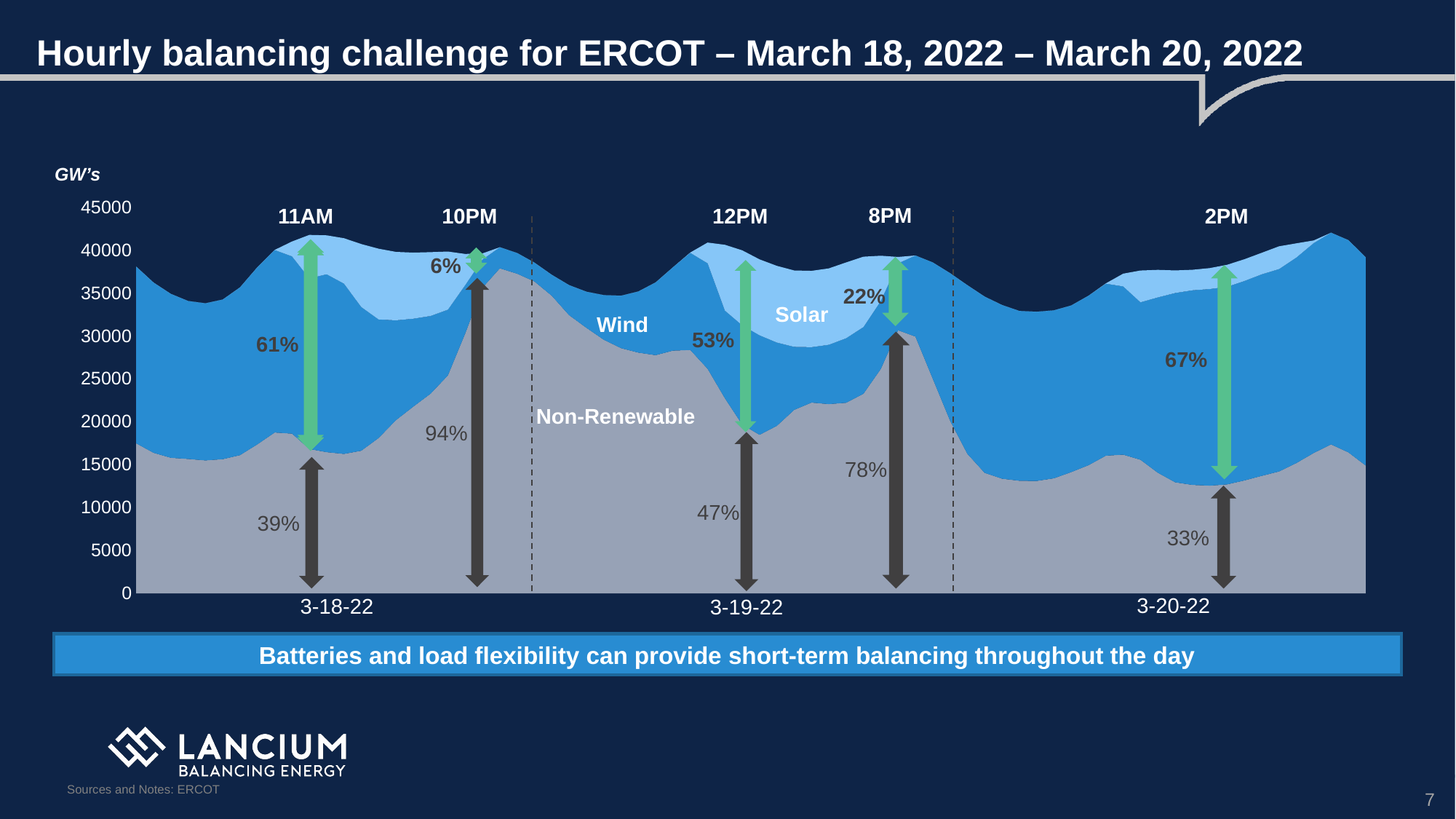
What renewable share (green arrow) is labelled at 2PM on 3-20-22? 67% At which labelled time is the renewable share (green arrow) the lowest? 10PM on 3-18-22 Which is larger: the renewable share labelled at 12PM on 3-19-22 or the renewable share labelled at 8PM on 3-19-22? 12PM on 3-19-22 What is the difference between the renewable share (61%) and the non-renewable share (39%) labelled at 11AM on 3-18-22? 22 percentage points Is the Non-Renewable value at 11AM on 3-18-22 greater or less than 20000? less What kind of chart is shown on the slide? area chart What non-renewable share (black arrow) is labelled at 10PM on 3-18-22? 94% How many dates are labelled along the x axis? 3 What are the three stacked series labelled on the chart? Non-Renewable, Wind, Solar What non-renewable share (black arrow) is labelled at 8PM on 3-19-22? 78% What renewable share (green arrow) is labelled at 11AM on 3-18-22? 61% At which labelled time is the non-renewable share (black arrow) the highest? 10PM on 3-18-22